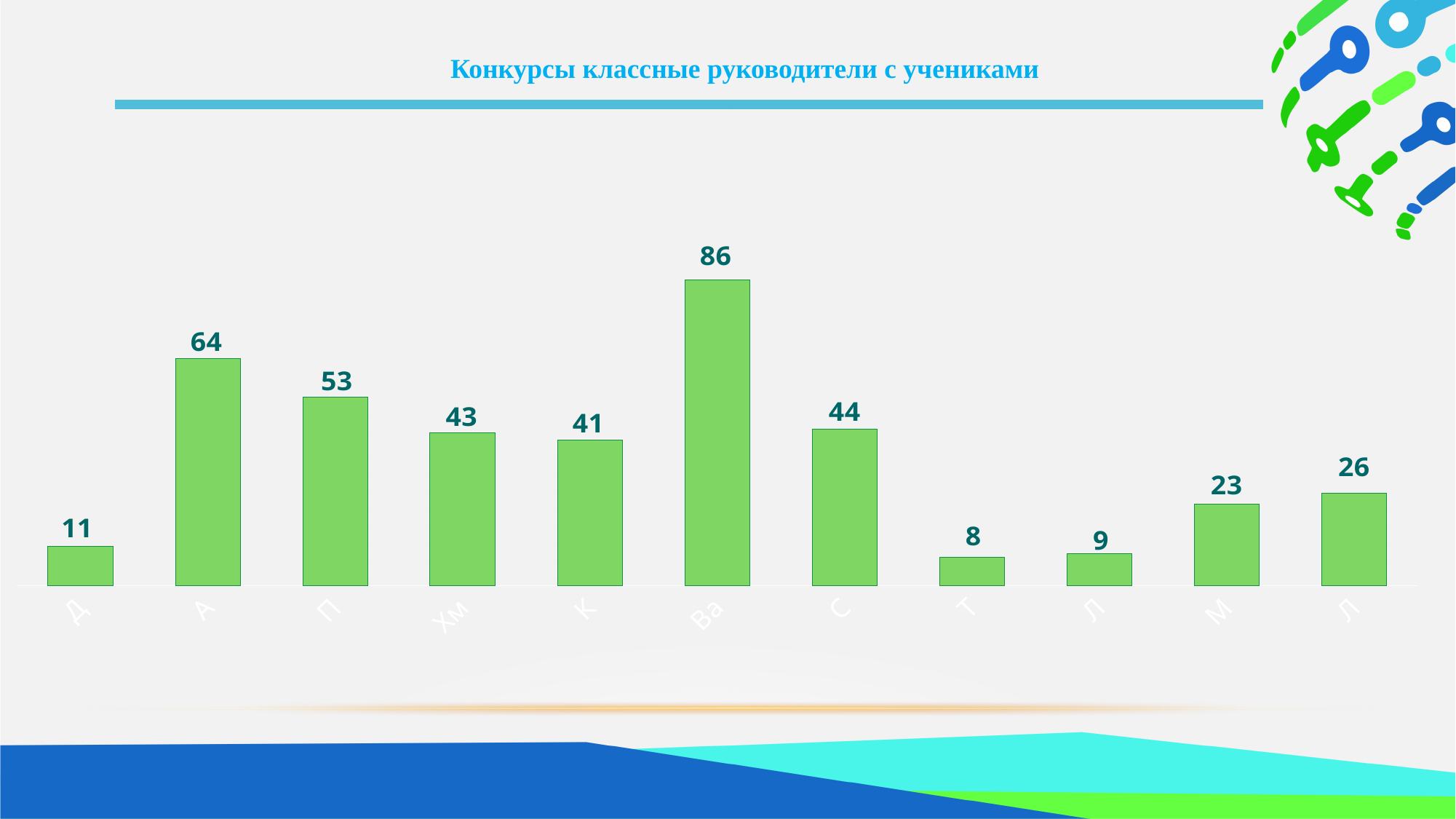
What is the difference between the values for П and С? 9 What is the value for Ва? 86 Which category has the highest value? Ва Which is larger, the value for С or the value for К? С How many bars are in the chart? 11 What is the value for Хм? 43 Which category has the lowest value? Т What is the title of the chart? Конкурсы классные руководители с учениками What type of chart is shown? Bar chart What is the difference between the values for Ва and А? 22 What is the value for А? 64 What is the value for Т? 8